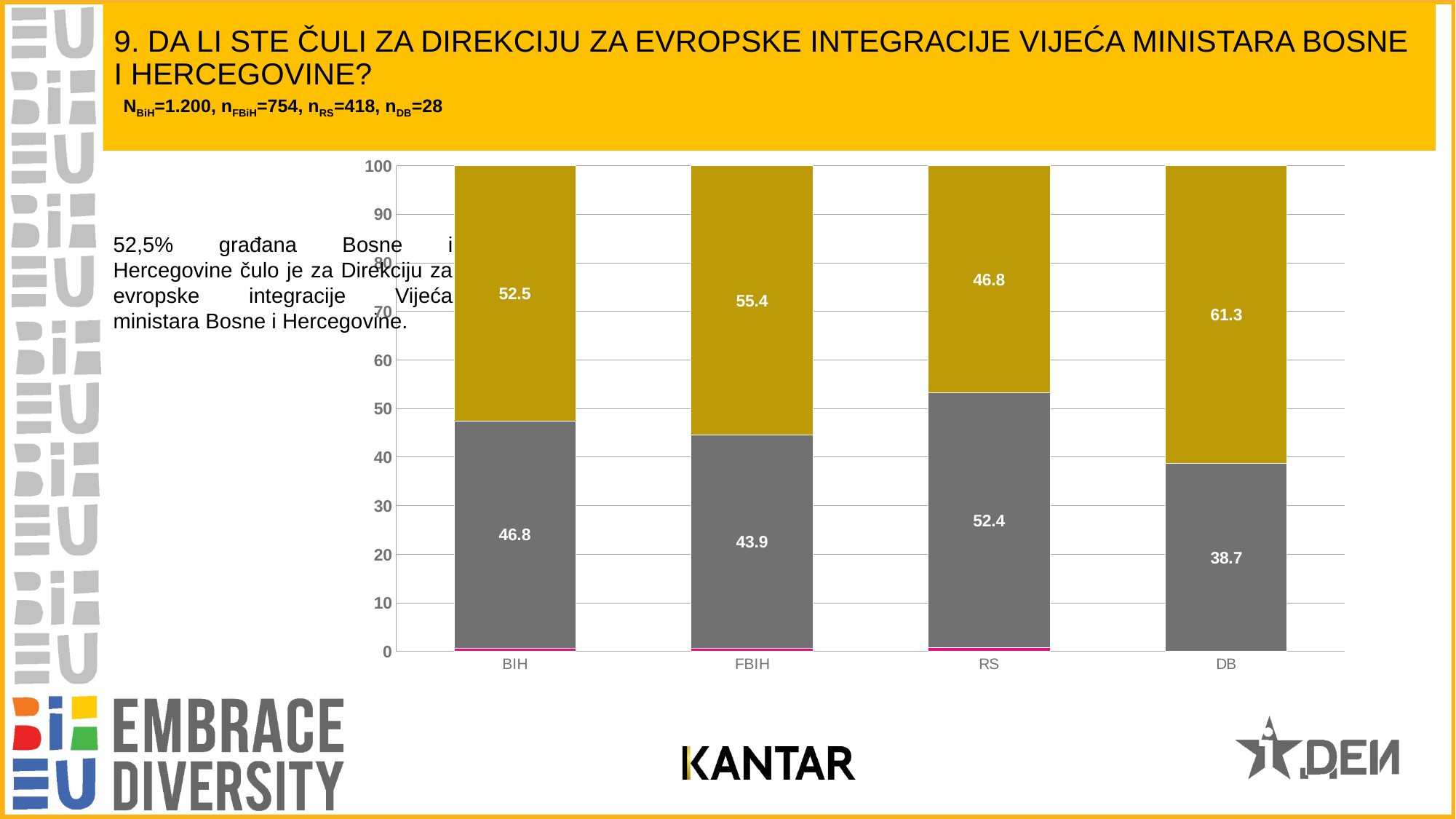
What is the value of the grey (lower) segment for RS? 52.4 What kind of chart is shown on the slide? Stacked bar chart Which is larger: the gold segment for FBIH or the gold segment for BIH? FBIH Which category has the highest value in the gold (top) segment? DB What is the difference between the gold segment values for DB and RS? 14.5 What is the value of the gold (top) segment for DB? 61.3 What is the value of the gold (top) segment for BIH? 52.5 How many categories are shown on the x axis? 4 Which category has the lowest value in the grey (lower) segment? DB Which category has the highest value in the grey (lower) segment? RS What is the value of the grey (lower) segment for FBIH? 43.9 What is the maximum value shown on the y axis? 100